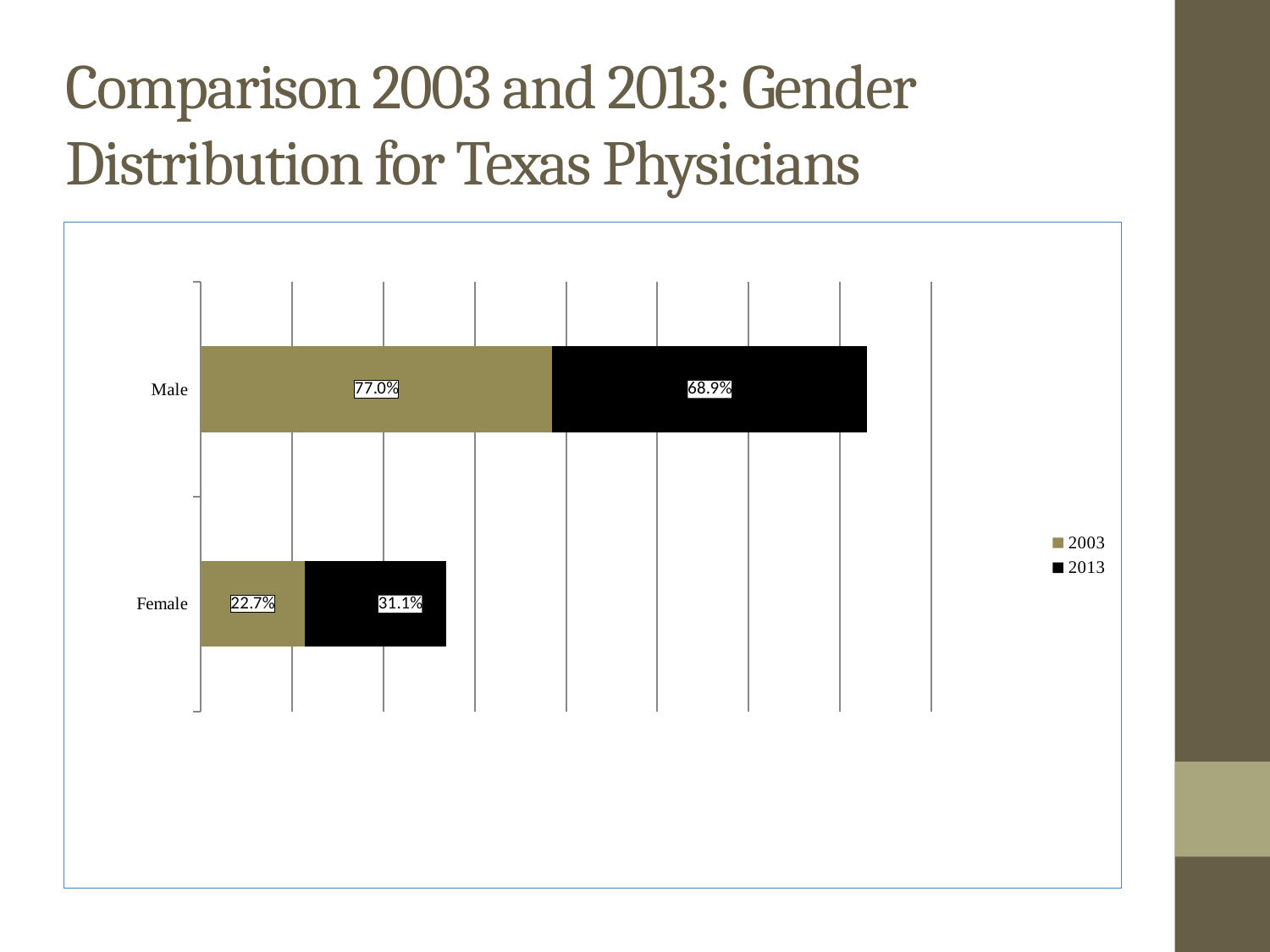
How many series does the legend list? 2 What is the value for Male in the 2013 series? 68.9% How many categories are shown on the chart? 2 What is the difference between the Male values for 2003 and 2013? 8.1% What is the difference between the Female values for 2013 and 2003? 8.4% What is the value for Female in the 2003 series? 22.7% What is the value for Female in the 2013 series? 31.1% Which category has the lowest value in the 2013 series? Female Which is larger for Female: the 2003 value or the 2013 value? 2013 What kind of chart is shown on the slide? Stacked bar chart Which category has the highest value in the 2003 series? Male What is the value for Male in the 2003 series? 77.0%